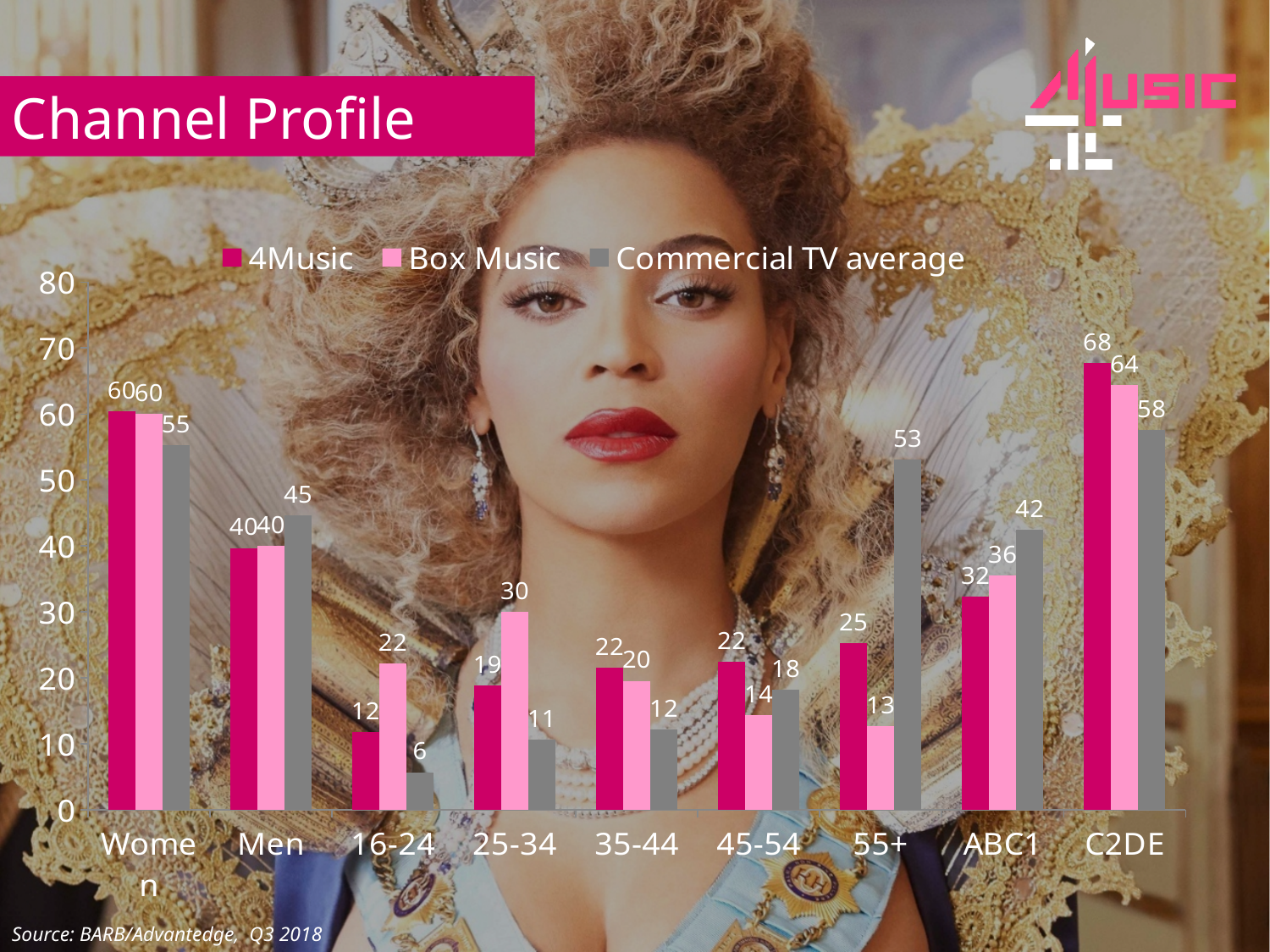
Which category has the lowest Commercial TV average value? 16-24 What is the 4Music value for the 16-24 category? 12 How many categories are shown on the x axis? 9 What is the source cited at the bottom of the slide? BARB/Advantedge, Q3 2018 Is the Box Music value for the 45-54 category greater or less than 20? less What is the difference between the 4Music and Commercial TV average values for the 55+ category? 28 What kind of chart is shown on the slide? bar chart What is the Commercial TV average value for the 55+ category? 53 What is the Box Music value for the 25-34 category? 30 How many series does the legend list? 3 Which category has the highest 4Music value? C2DE For the ABC1 category, which is larger: the Box Music value or the Commercial TV average value? Commercial TV average